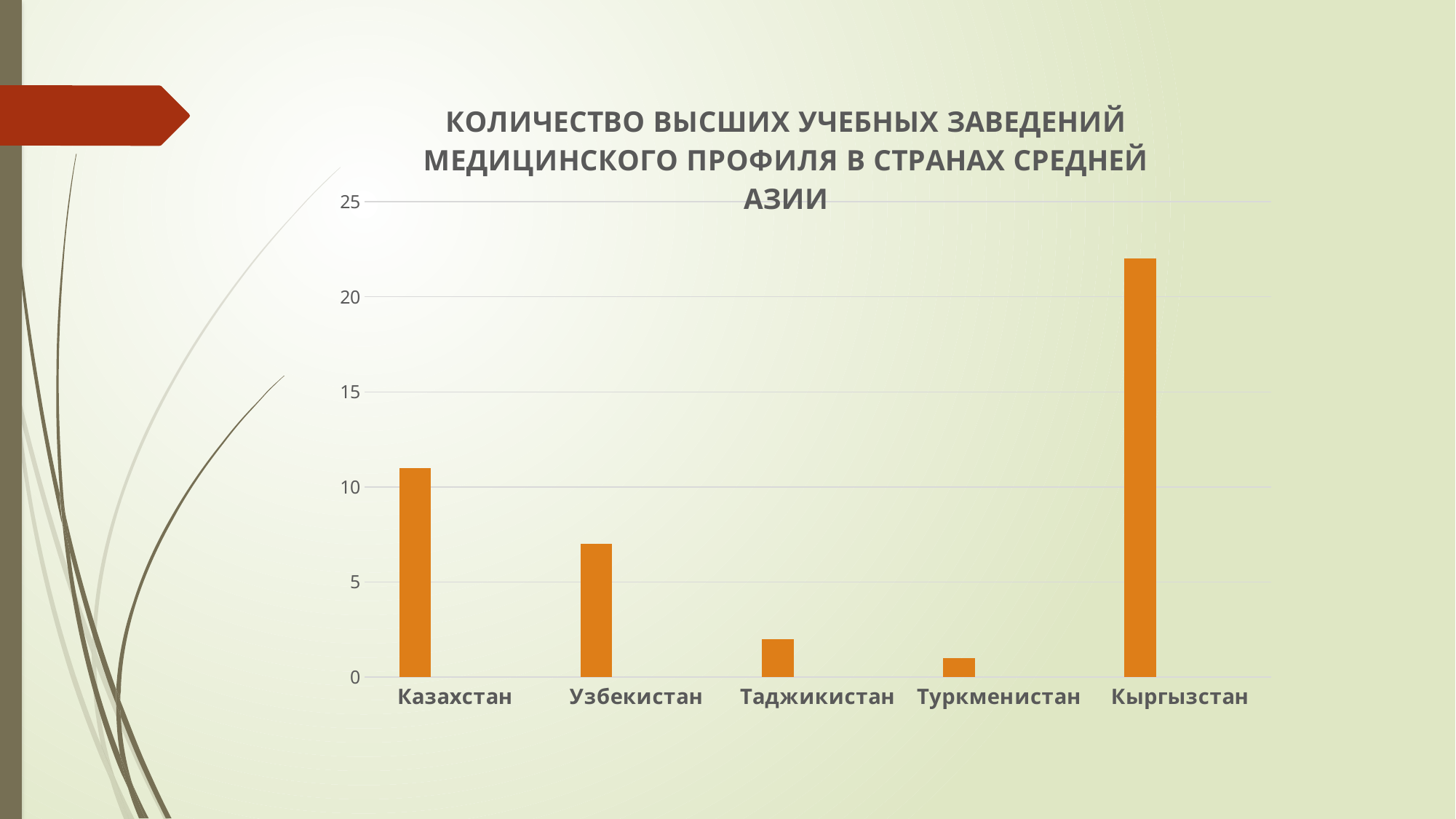
How many countries are shown on the x axis of the chart? 5 Which has a higher value in the chart, Таджикистан or Туркменистан? Таджикистан Is the value for Кыргызстан greater or less than 20? greater Is the value for Казахстан greater or less than 15? less Is the value for Узбекистан greater or less than 5? greater Which country has the highest number of medical higher education institutions in the chart? Кыргызстан What colour are the bars in the chart? Orange Which country has the lowest bar in the chart? Туркменистан What kind of chart is shown on the slide? Bar chart Which has a higher value in the chart, Казахстан or Узбекистан? Казахстан What is the title of the chart? КОЛИЧЕСТВО ВЫСШИХ УЧЕБНЫХ ЗАВЕДЕНИЙ МЕДИЦИНСКОГО ПРОФИЛЯ В СТРАНАХ СРЕДНЕЙ АЗИИ